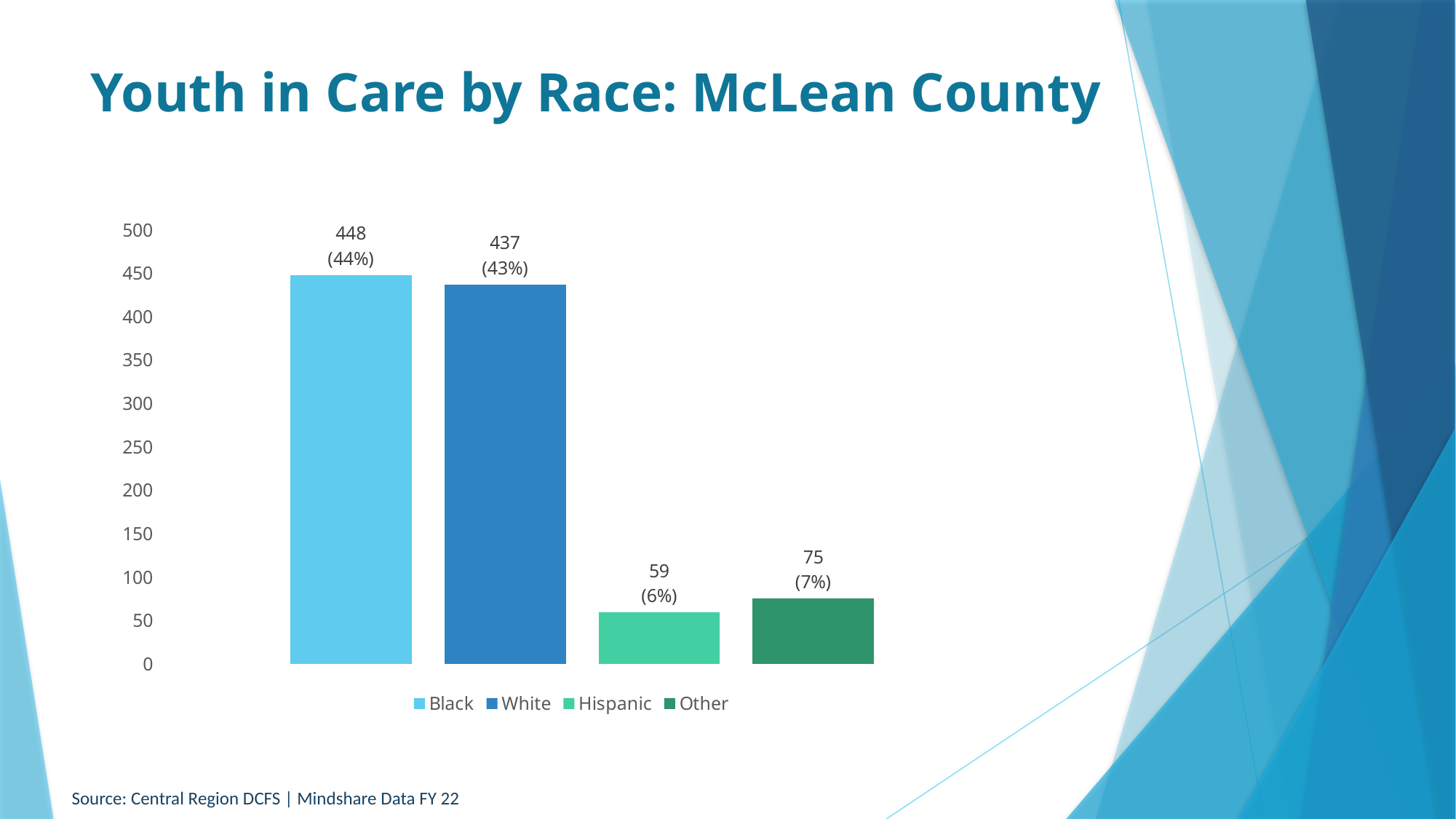
What is the number of youth in care for Black youth? 448 What kind of chart is shown on the slide? Bar chart What is the title of the chart? Youth in Care by Race: McLean County Which category has the highest number of youth in care? Black What is the difference between the Other and Hispanic values? 16 What percentage is shown for the Other category? 7% What is the difference between the Black and White values? 11 Which is larger, the value for Other or the value for Hispanic? Other Is the value for White greater or less than 400? greater How many categories are shown in the chart? 4 Which category has the lowest number of youth in care? Hispanic What is the number of youth in care for Hispanic youth? 59